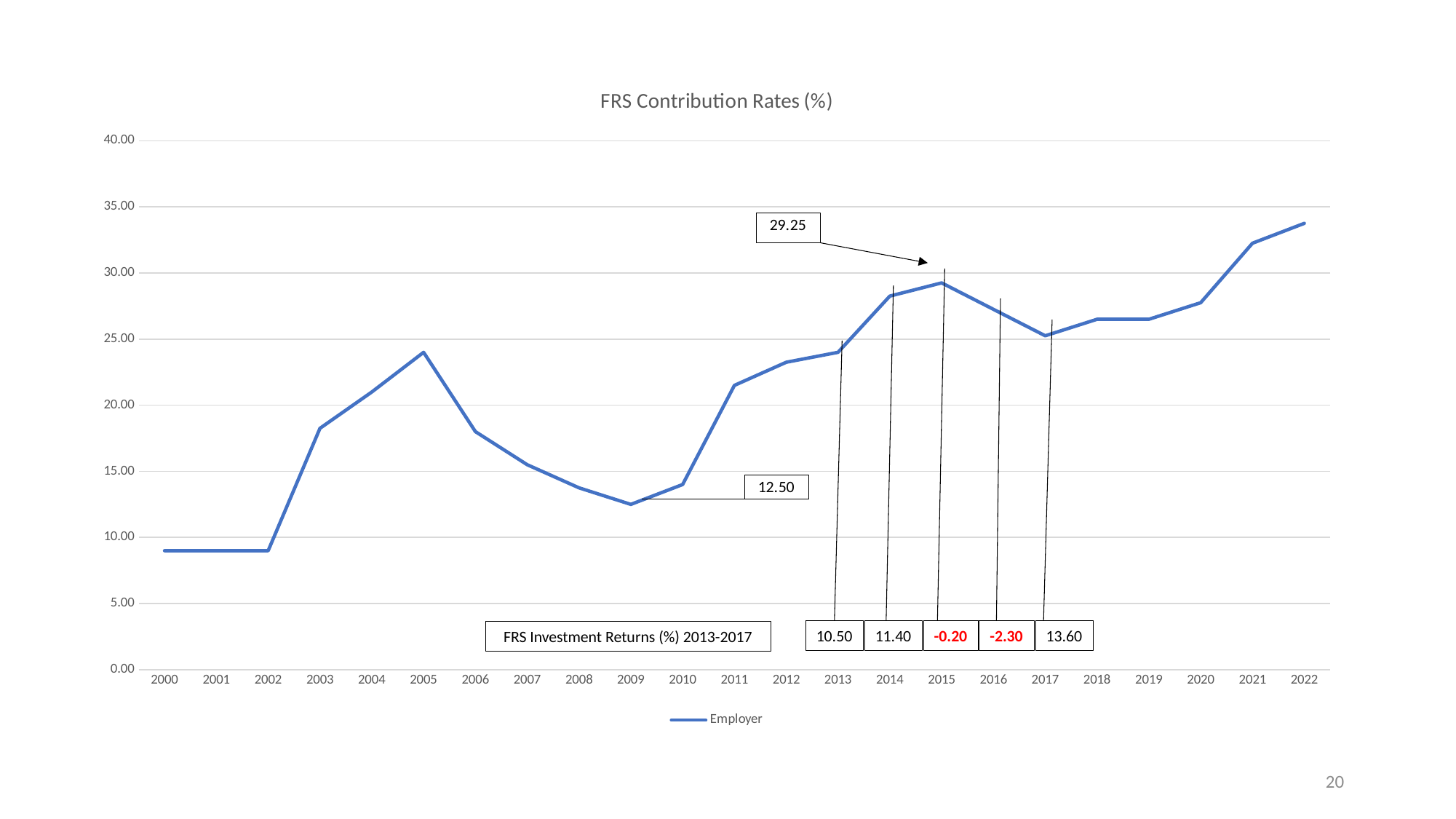
What type of chart is shown on the slide? line chart How many years are plotted along the x axis? 23 Is the Employer contribution rate for 2000 greater or less than 10.00? less What is the difference between the labelled values for 2015 and 2009? 16.75 How many series does the legend list? 1 What is the labelled Employer contribution rate for 2009? 12.50 Do the Employer contribution rates rise or fall from 2005 to 2009? fall What FRS investment return is shown for 2017? 13.60 What FRS investment return is shown for 2016? -2.30 What is the labelled Employer contribution rate for 2015? 29.25 What is the title of the chart? FRS Contribution Rates (%) Which year has the highest Employer contribution rate? 2022